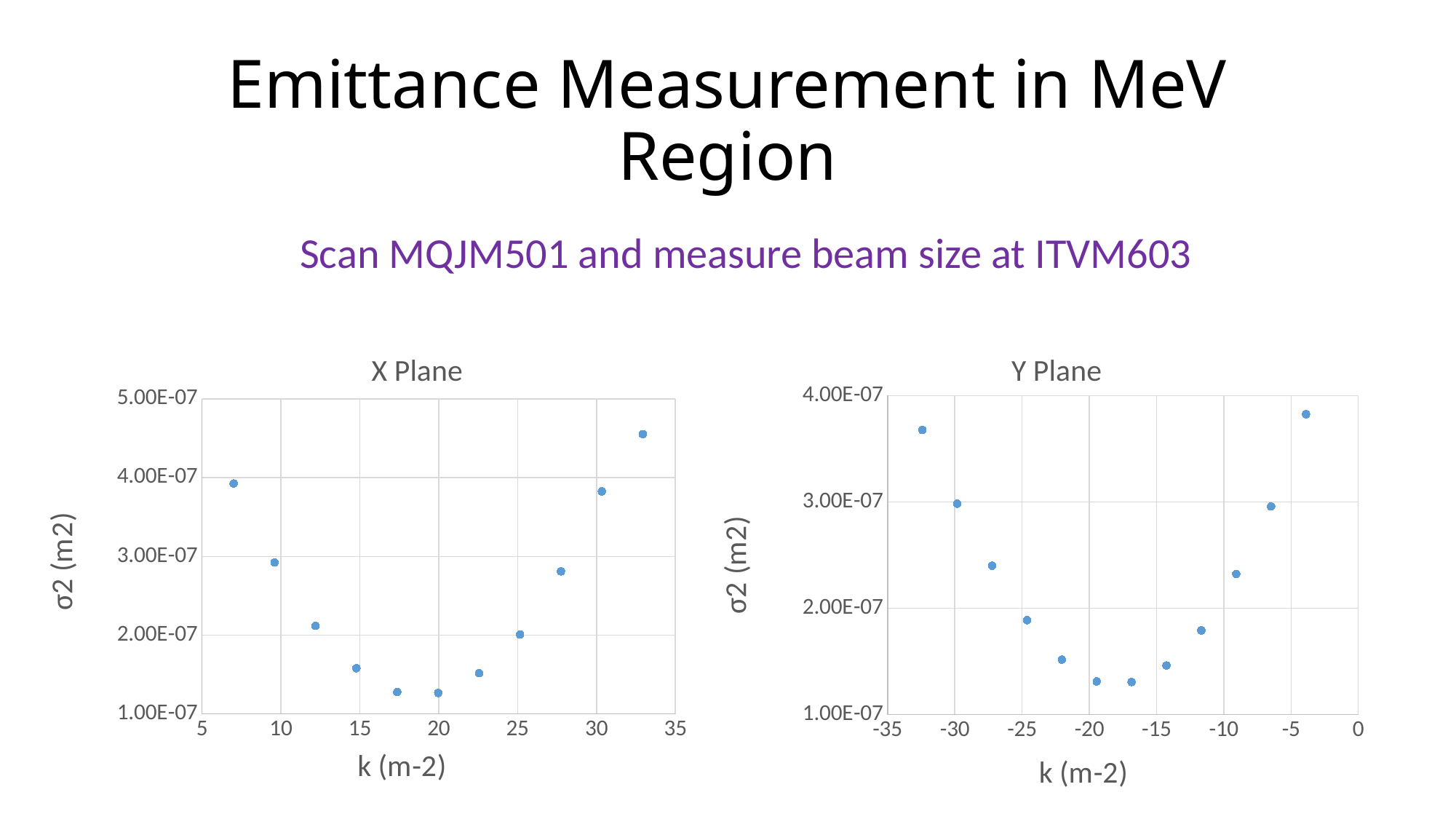
In the X Plane chart, is the value of the rightmost point (near k = 33) greater or less than 4.00E-07? greater In the Y Plane chart, is the value of the point near k = -25 greater or less than 2.00E-07? less How many data points are plotted in the Y Plane chart? 12 What is the x-axis title of the Y Plane chart? k (m-2) How many data points are plotted in the X Plane chart? 11 In the X Plane chart, which point has the highest σ2 value? the rightmost point, near k = 33 In the Y Plane chart, which is larger: the σ2 value at k ≈ -30 or at k ≈ -27? k ≈ -30 What kind of chart is the X Plane chart? scatter chart In the X Plane chart, how do the σ2 values change as k increases from 5 to 35? they fall and then rise In the X Plane chart, is the value of the leftmost point (near k = 7) greater or less than 4.00E-07? less In the X Plane chart, which is larger: the σ2 value of the leftmost point or of the rightmost point? the rightmost point